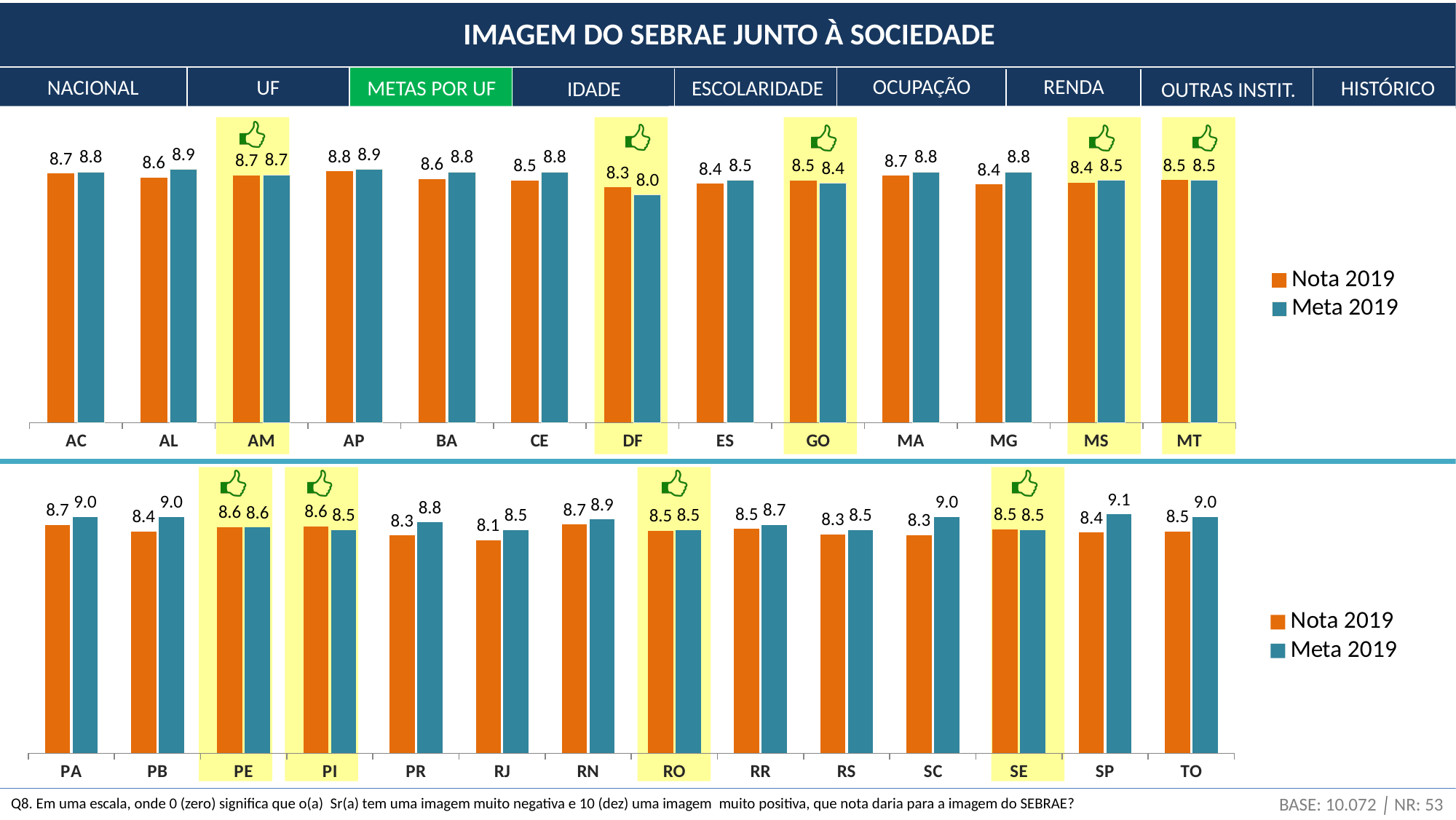
In the bottom chart (PA to TO), is the Nota 2019 value for PI larger or smaller than its Meta 2019 value? larger In the top chart (AC to MT), which state has the lowest Nota 2019 value? DF In the bottom chart (PA to TO), which state has the highest Meta 2019 value? SP In the top chart (AC to MT), what is the Nota 2019 value for AL? 8.6 In the bottom chart (PA to TO), which state has the lowest Nota 2019 value? RJ In the bottom chart (PA to TO), how many series does the legend list? 2 What type of chart is used on this slide? Bar chart In the top chart (AC to MT), what is the difference between the Meta 2019 and Nota 2019 values for CE? 0.3 In the top chart (AC to MT), which state has the highest Nota 2019 value? AP In the top chart (AC to MT), what is the Meta 2019 value for MG? 8.8 In the top chart (AC to MT), how many states are shown on the x axis? 13 In the bottom chart (PA to TO), what is the Meta 2019 value for SP? 9.1